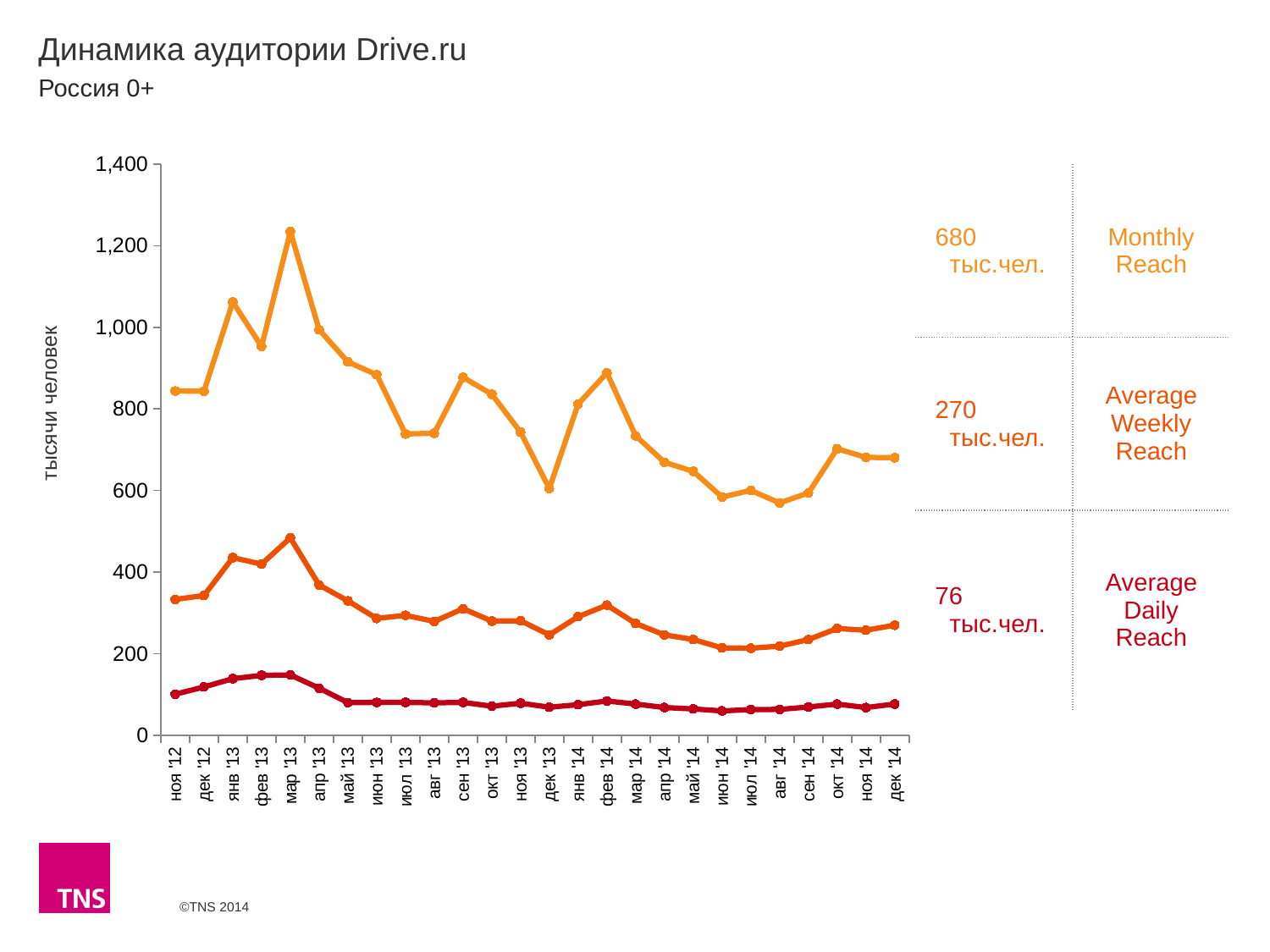
How many series does the chart show? 3 What is the label on the y axis? тысячи человек What is the Average Weekly Reach value for дек '14? 270 тыс.чел. What is the Average Daily Reach value for дек '14? 76 тыс.чел. What is the Monthly Reach value for дек '14? 680 тыс.чел. In which month does Monthly Reach reach its highest value? мар '13 Is the Monthly Reach value for дек '13 greater or less than 800? less Does Monthly Reach rise or fall from мар '13 to май '13? fall Is the Monthly Reach value for мар '13 greater or less than 1,000? greater Which is higher, Monthly Reach in янв '13 or in фев '13? янв '13 How many monthly data points are plotted along the x axis? 26 What kind of chart is shown on the slide? line chart